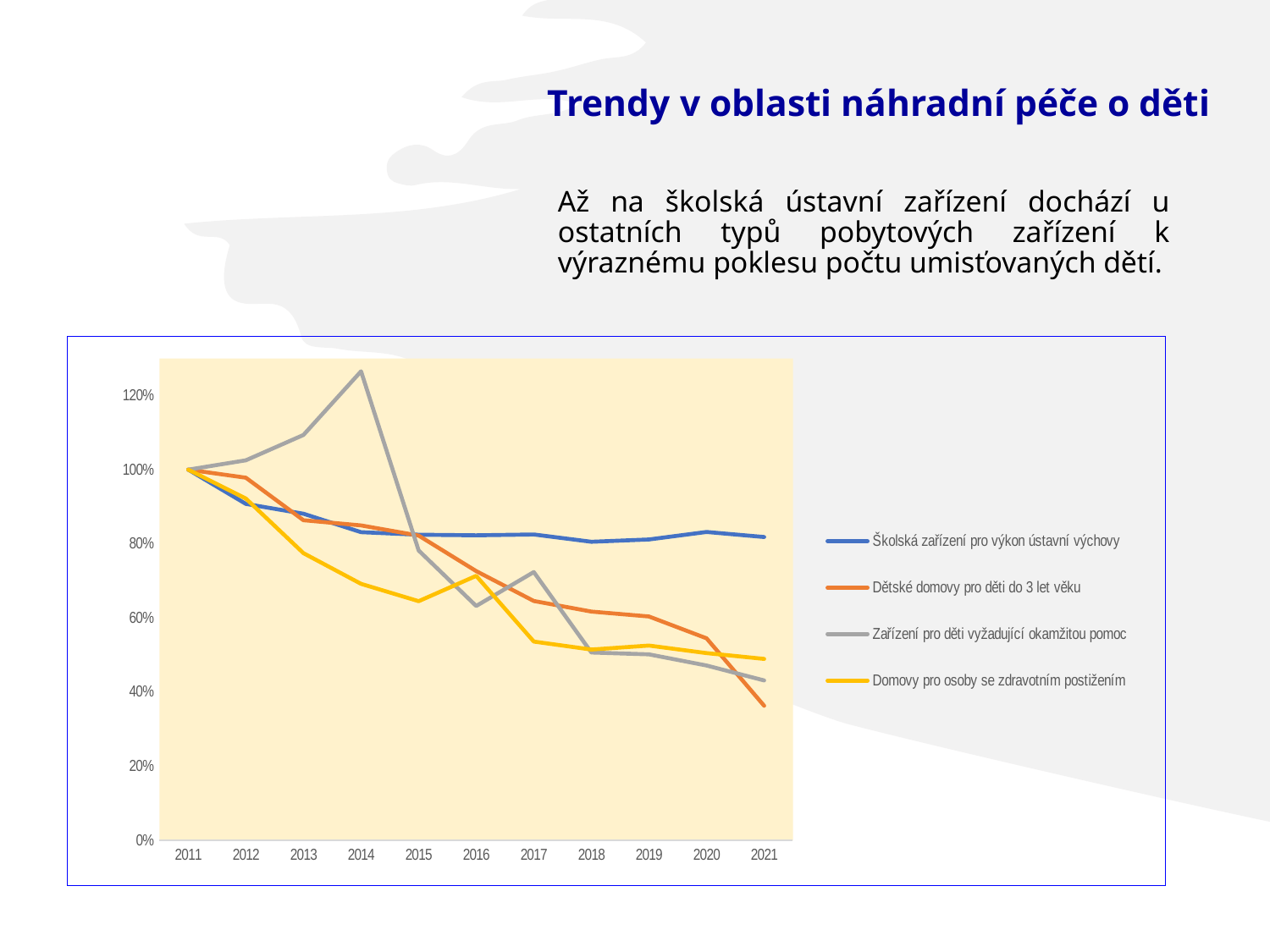
Which series has the highest value in 2021? Školská zařízení pro výkon ústavní výchovy Which series has the lowest value in 2021? Dětské domovy pro děti do 3 let věku Is the value for Zařízení pro děti vyžadující okamžitou pomoc in 2014 greater or less than 120%? greater What is the value for Školská zařízení pro výkon ústavní výchovy in 2011? 100% How many series does the chart's legend list? 4 What kind of chart is shown on the slide? line chart Is the value for Dětské domovy pro děti do 3 let věku in 2021 greater or less than 40%? less Is the value for Domovy pro osoby se zdravotním postižením in 2021 greater or less than 60%? less What is the value for Dětské domovy pro děti do 3 let věku in 2011? 100% Does the value for Dětské domovy pro děti do 3 let věku rise or fall from 2011 to 2021? fall How many years are plotted along the x axis of the chart? 11 In 2014, which is higher: Zařízení pro děti vyžadující okamžitou pomoc or Školská zařízení pro výkon ústavní výchovy? Zařízení pro děti vyžadující okamžitou pomoc